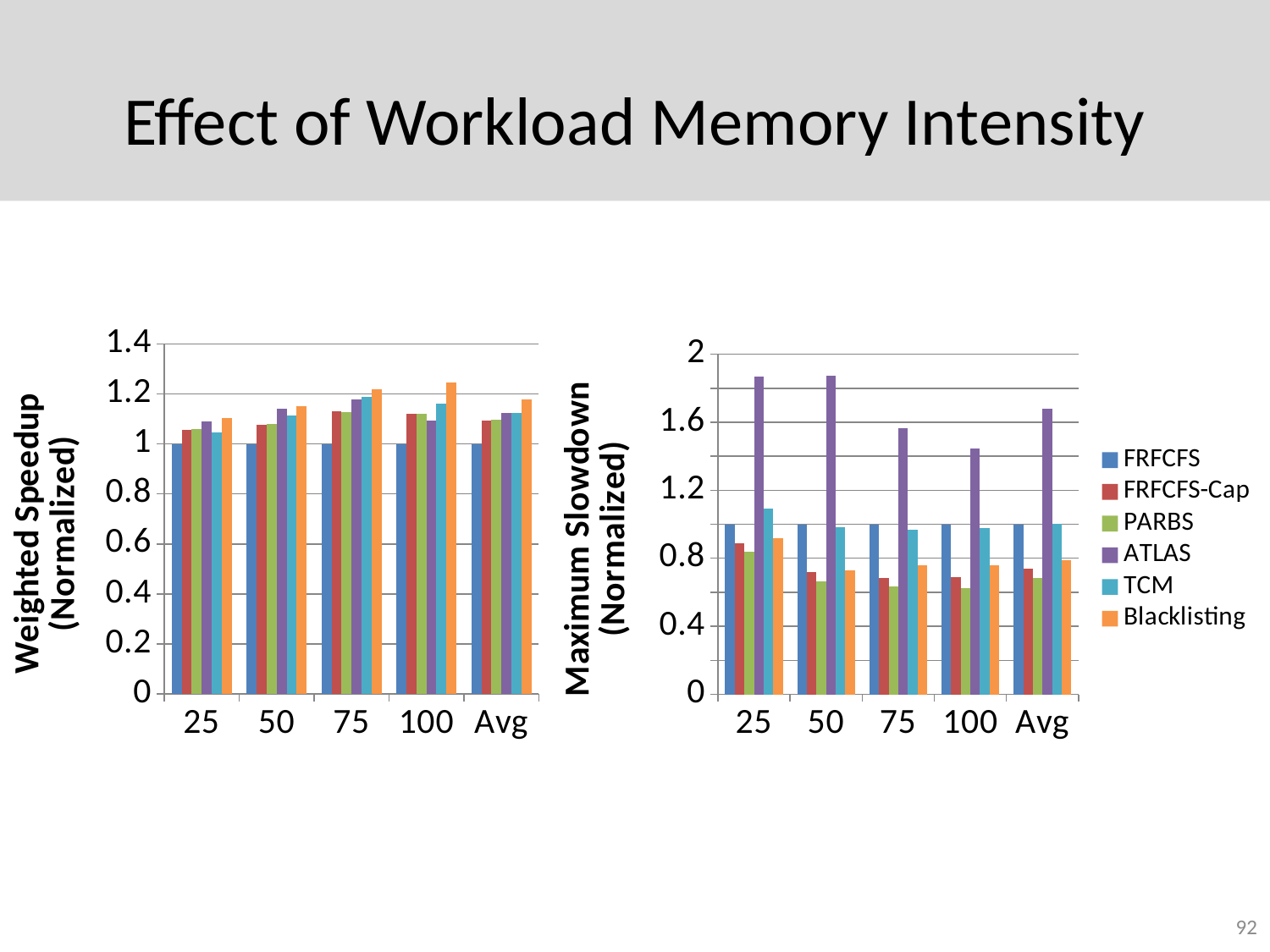
In the Maximum Slowdown (Normalized) chart on the right, is the value for ATLAS at 25 greater or less than 1.6? greater In the Maximum Slowdown (Normalized) chart on the right, is the value for TCM at 25 greater or less than 0.8? greater In the Maximum Slowdown (Normalized) chart on the right, is the value for ATLAS at 100 greater or less than 1.2? greater What kind of chart is the Weighted Speedup (Normalized) chart on the left? bar chart In the Maximum Slowdown (Normalized) chart on the right, which series has the highest value at 25? ATLAS What is the y-axis title of the chart on the right? Maximum Slowdown (Normalized) In the Maximum Slowdown (Normalized) chart on the right, does the ATLAS value rise or fall from 25 to 100? fall In the Weighted Speedup (Normalized) chart on the left, which series has the highest value at 100? Blacklisting In the Weighted Speedup (Normalized) chart on the left, which is larger at 75: Blacklisting or FRFCFS? Blacklisting How many series does the legend list for the charts on this slide? 6 How many categories are shown on the x axis of the Maximum Slowdown (Normalized) chart on the right? 5